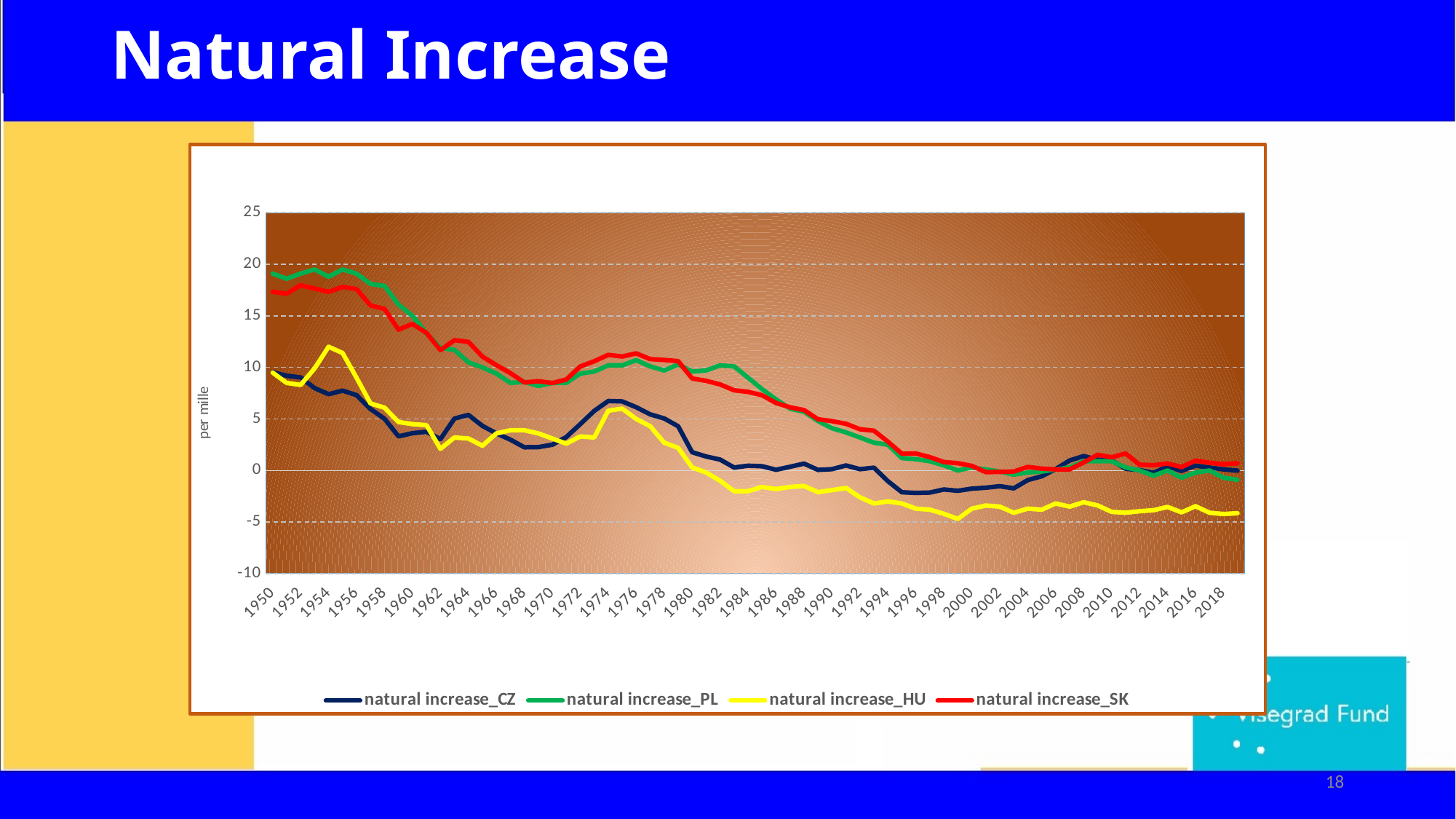
Is the value for natural increase_PL in 1950 greater or less than 15? greater Does natural increase_PL generally rise or fall from 1950 to 2018? fall What kind of chart is shown on the slide? line chart Is the value for natural increase_CZ in 1950 greater or less than 5? greater Which series has the lowest value in 2010? natural increase_HU In 1990, which is larger: natural increase_PL or natural increase_HU? natural increase_PL Is the value for natural increase_SK in 1960 greater or less than 10? greater What is the label on the vertical axis? per mille Which series is plotted in yellow? natural increase_HU Which series has the highest value in 1950? natural increase_PL How many series does the legend list? 4